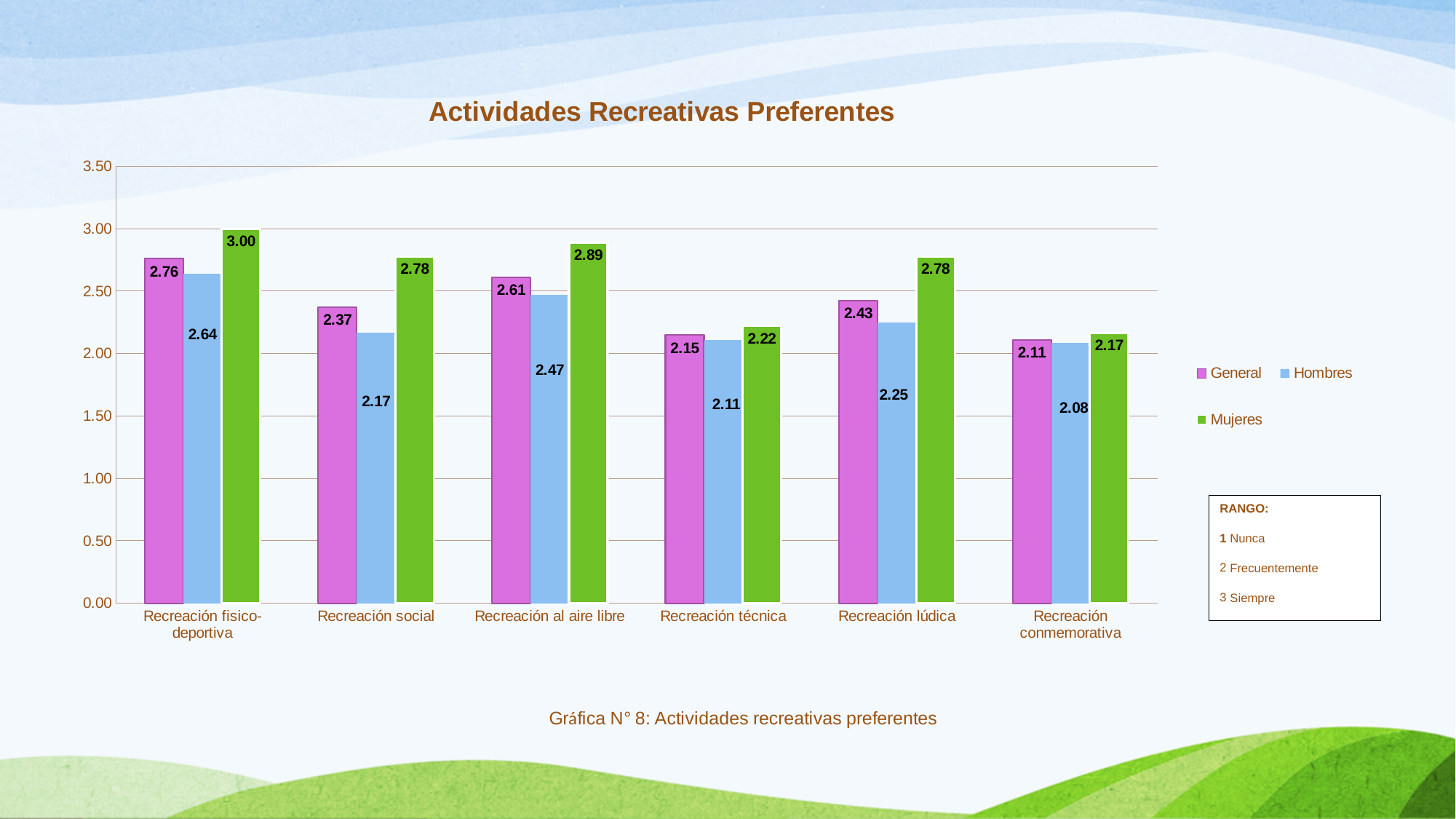
What is the title of the chart? Actividades Recreativas Preferentes Which is larger for Recreación técnica: the General value or the Mujeres value? Mujeres How many categories are shown on the x axis? 6 What is the difference between the Mujeres and Hombres values for Recreación social? 0.61 What is the General value for Recreación social? 2.37 Which category has the lowest Hombres value? Recreación conmemorativa What is the Mujeres value for Recreación al aire libre? 2.89 What kind of chart is shown? bar chart How many series does the legend list? 3 Is the Hombres value for Recreación físico-deportiva greater or less than 2.50? greater What is the Hombres value for Recreación lúdica? 2.25 Which category has the highest Mujeres value? Recreación físico-deportiva